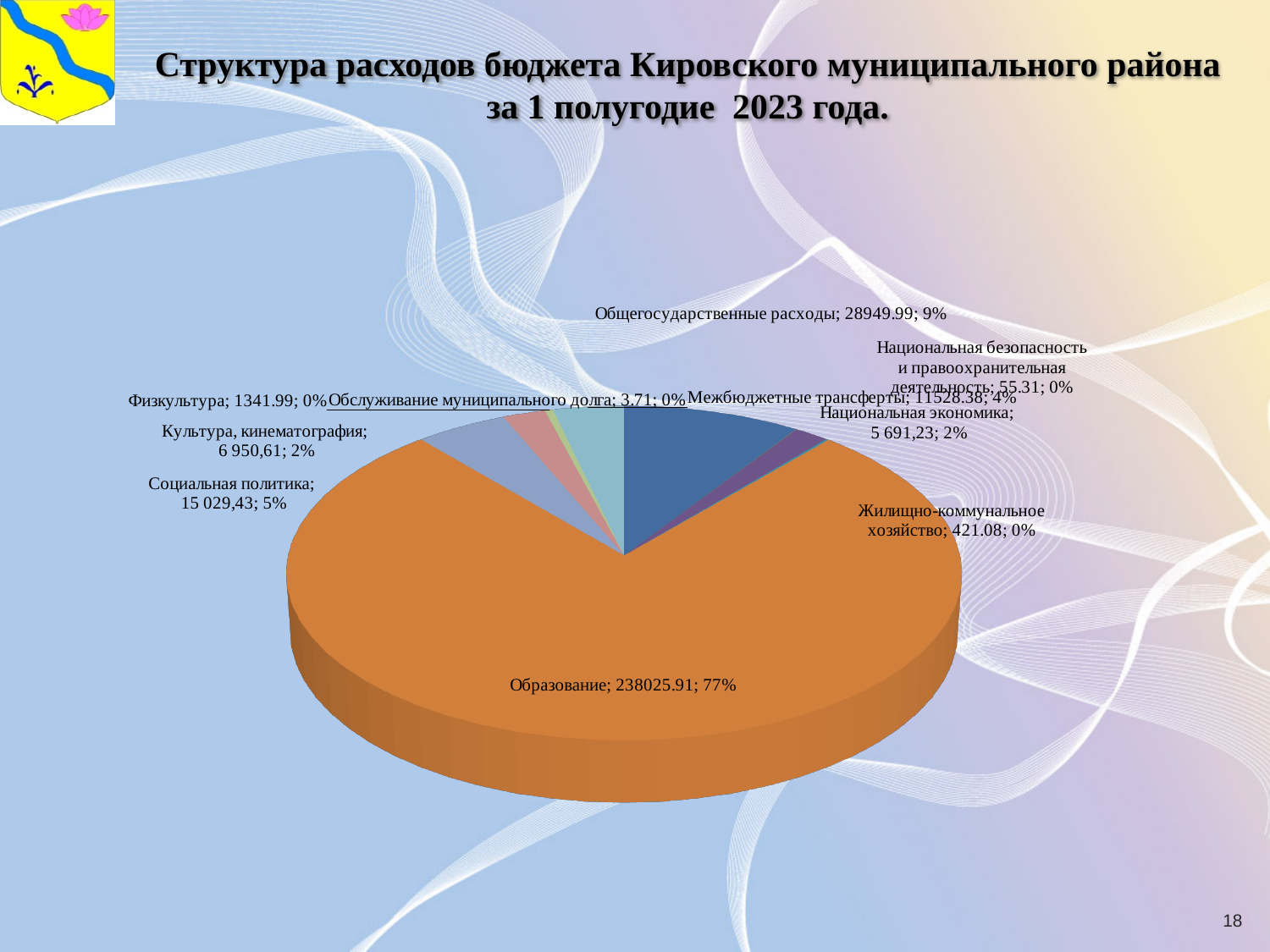
How many categories are shown in the pie chart? 10 What is the value shown for Социальная политика? 15 029,43 What kind of chart is shown on the slide? pie chart What is the value shown for Общегосударственные расходы? 28949.99 What is the difference between the values for Общегосударственные расходы and Межбюджетные трансферты? 17421.61 What share of the pie does Образование take? 77% What is the value shown for Межбюджетные трансферты? 11528.38 Which category has the smallest value in the pie? Обслуживание муниципального долга What is the value shown for Образование? 238025.91 What share of the pie does Общегосударственные расходы take? 9% Which is larger, the value for Социальная политика or the value for Культура, кинематография? Социальная политика Which category has the largest slice of the pie? Образование